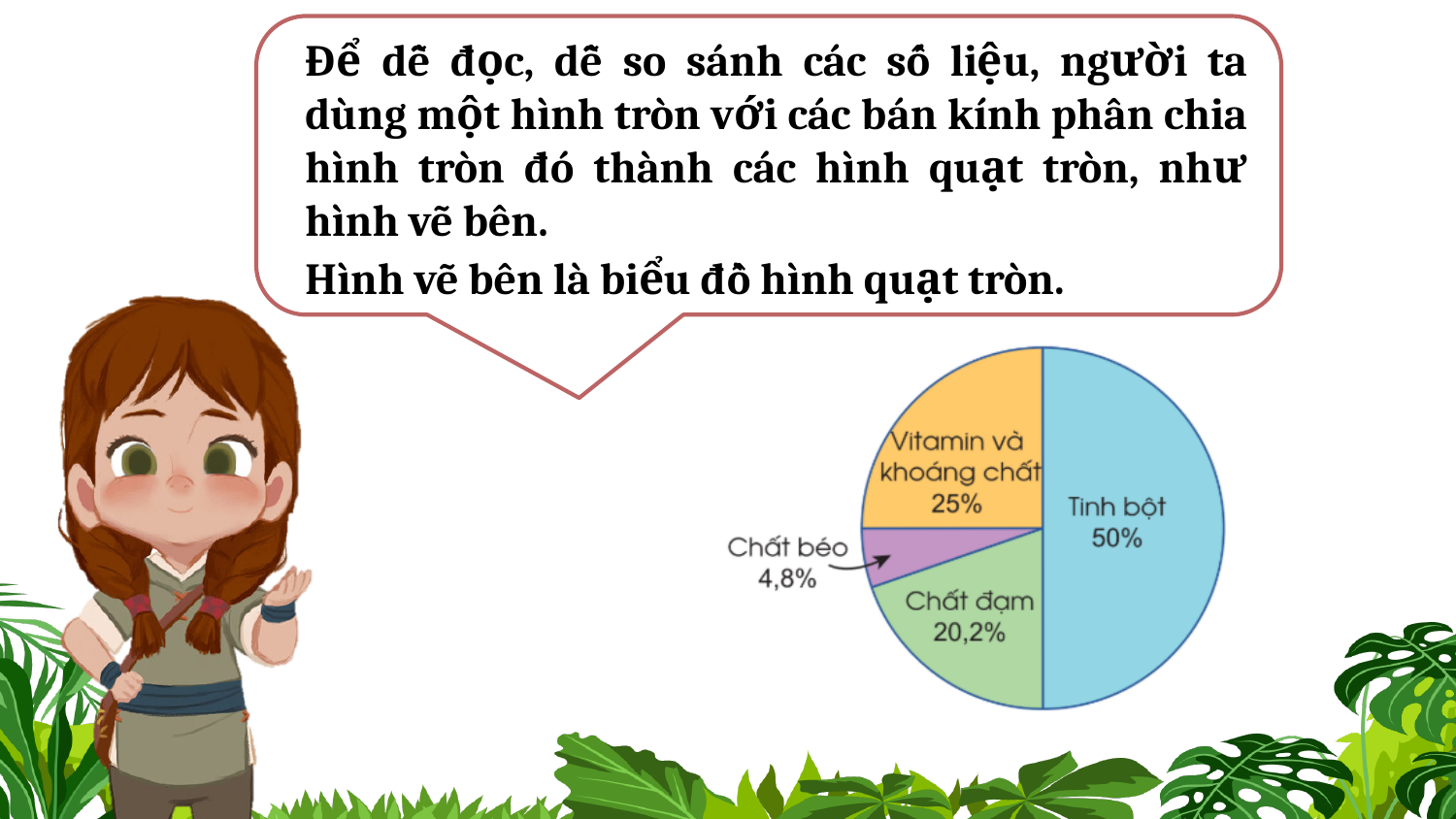
Which category has the smallest slice? Chất béo What is the share for Vitamin và khoáng chất? 25% What is the difference between the shares of Chất đạm and Chất béo? 15,4% What is the share for Tinh bột? 50% What kind of chart is shown on the slide? Pie chart What is the share for Chất béo? 4,8% What colour is the Tinh bột slice? Light blue What is the difference between the shares of Tinh bột and Vitamin và khoáng chất? 25% What is the share for Chất đạm? 20,2% Which is larger, the share of Chất đạm or the share of Vitamin và khoáng chất? Vitamin và khoáng chất Which category has the largest slice? Tinh bột How many slices does the pie chart have? 4